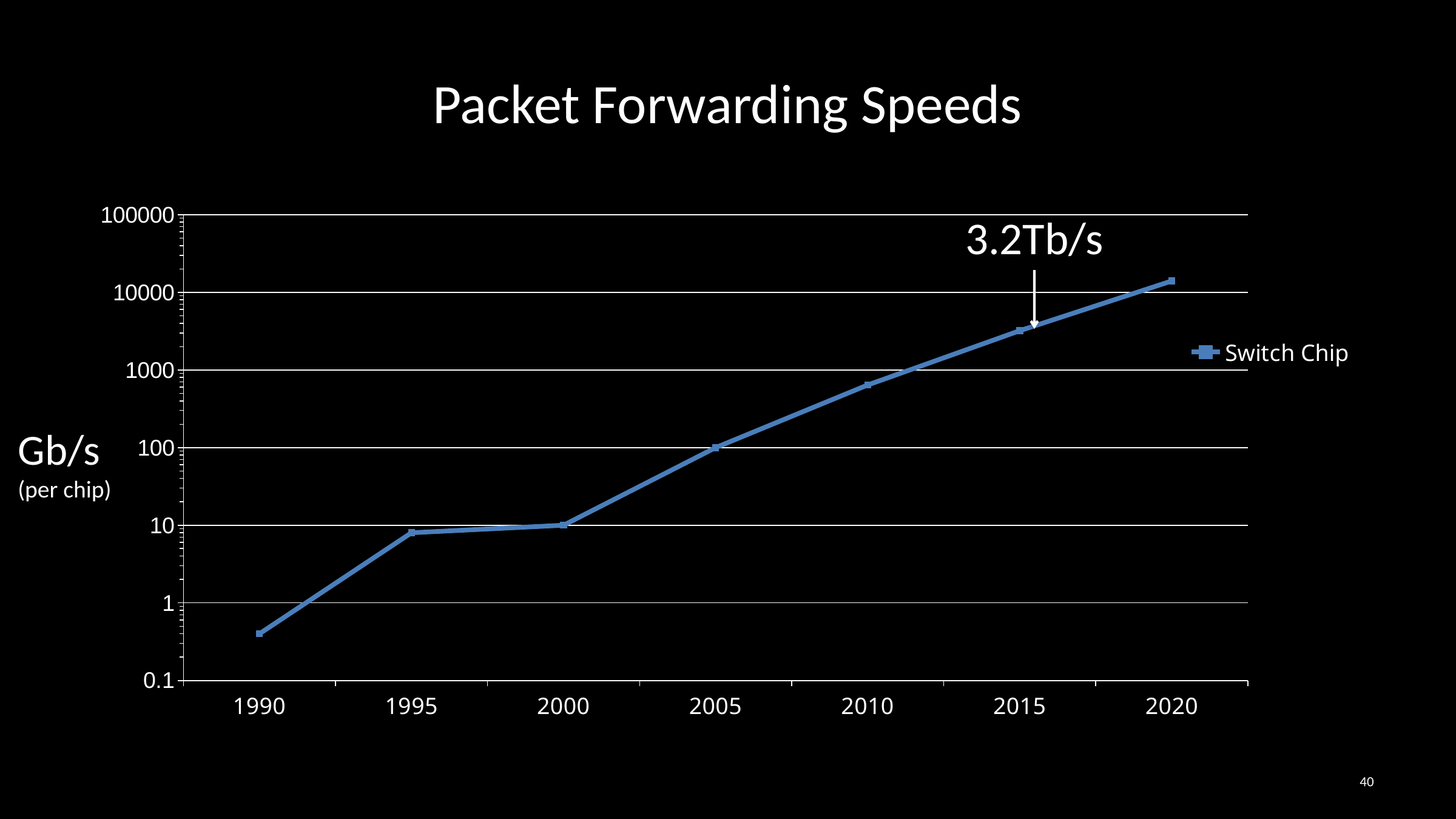
How many series does the legend list? 1 Is the Switch Chip value for 2020 greater or less than 10000? greater Which year has the highest Switch Chip value? 2020 What is the title of the chart? Packet Forwarding Speeds What speed is annotated for the 2015 data point? 3.2Tb/s How many data points are plotted on the Switch Chip line? 7 Is the Switch Chip value for 1990 greater or less than 1? less What is the Switch Chip value for 2005 in Gb/s? 100 What kind of chart is shown on the slide? line chart Which year has the lowest Switch Chip value? 1990 Do the Switch Chip values rise or fall from 1990 to 2020? rise What is the Switch Chip value for 2000 in Gb/s? 10